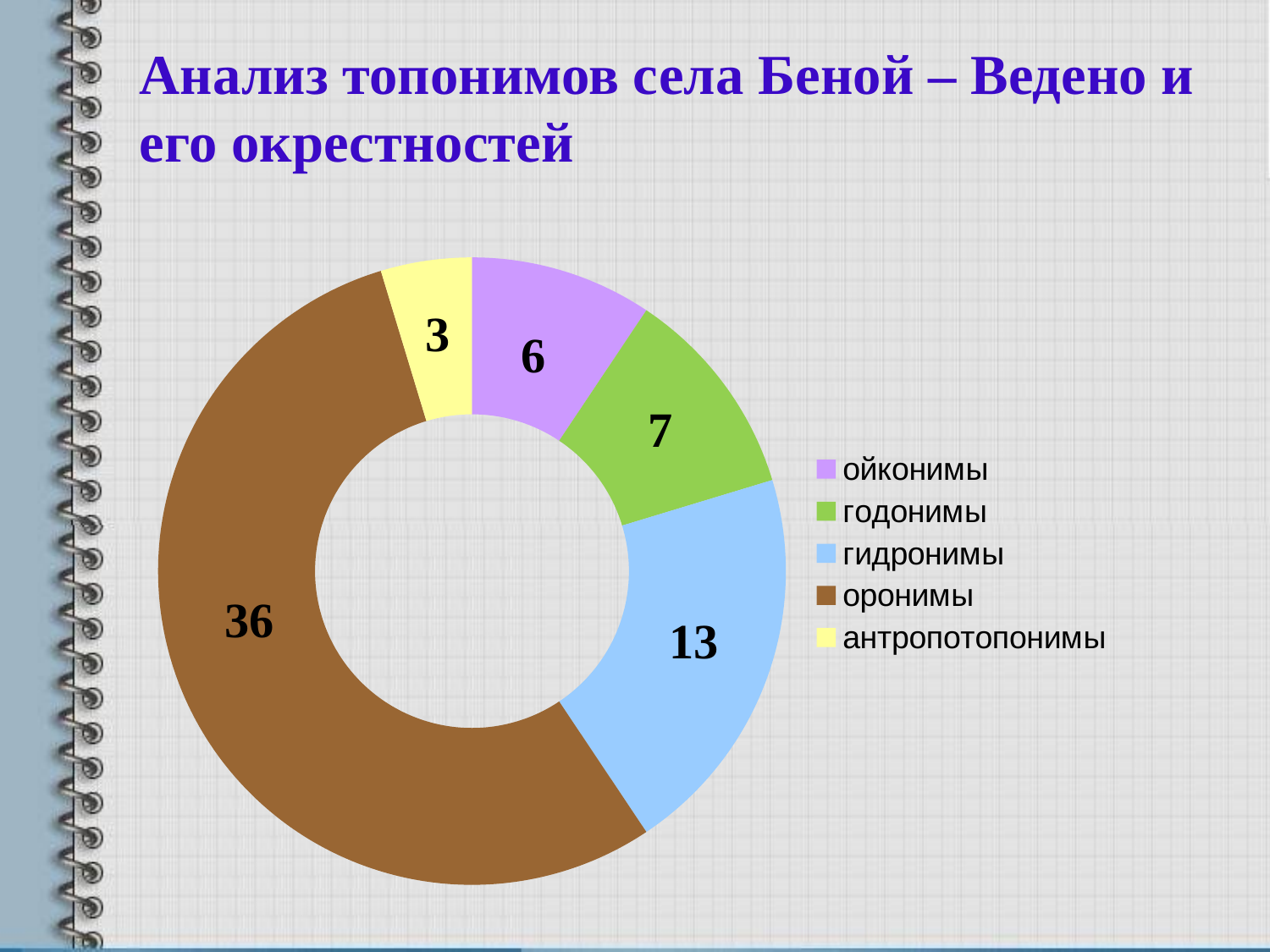
What is the difference between the values for оронимы and гидронимы? 23 What colour is the segment for гидронимы? Light blue What type of chart is shown on the slide? Doughnut chart What is the value for годонимы? 7 Which category has the highest value? оронимы Which category has the lowest value? антропотопонимы What is the value for антропотопонимы? 3 What is the value for гидронимы? 13 What is the total of all the values in the chart? 65 Which is larger, the value for ойконимы or the value for годонимы? годонимы How many categories does the chart show? 5 What is the value for оронимы? 36